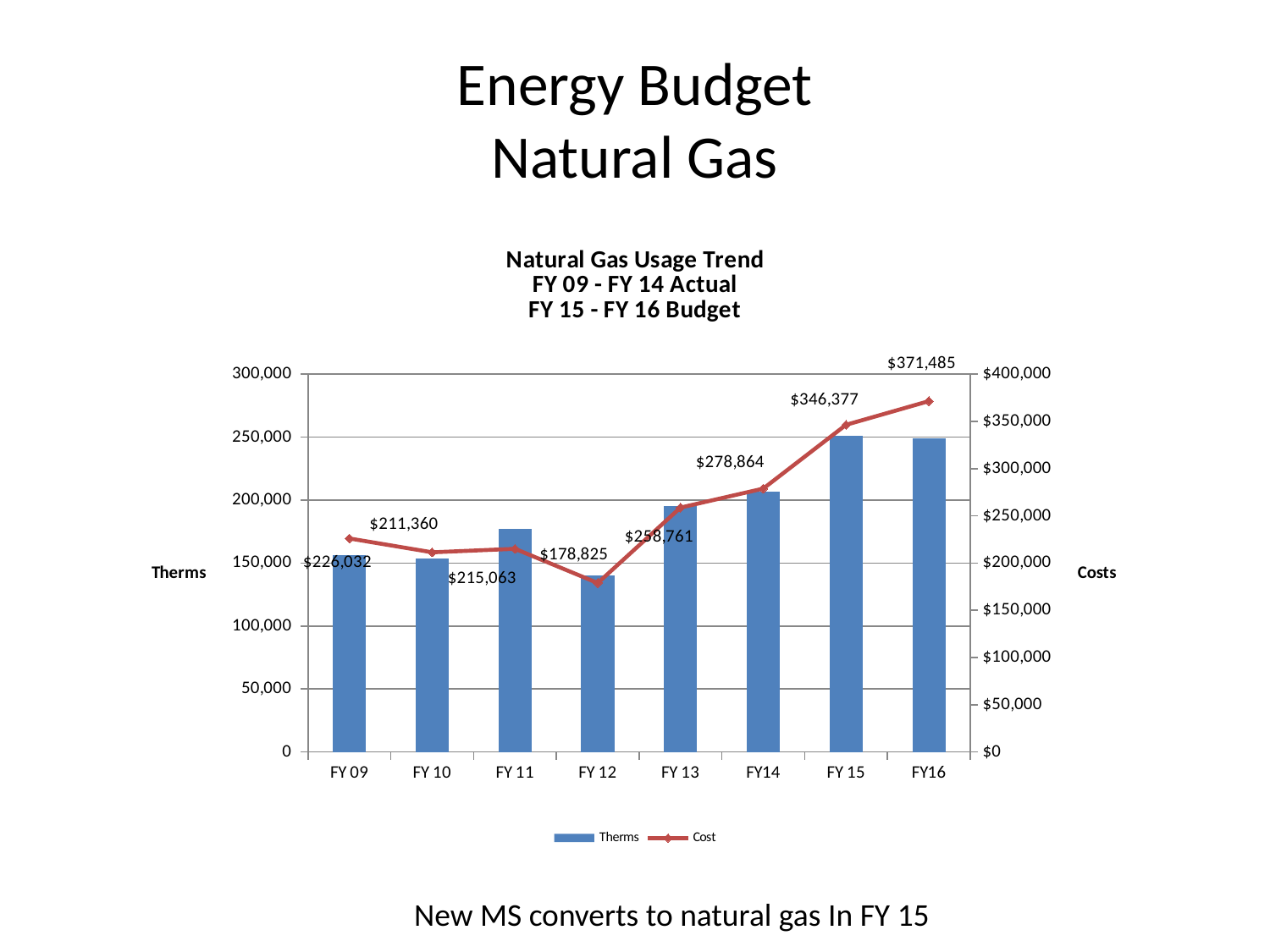
What is the cost value shown for FY16? $371,485 Which is larger, the cost for FY 09 or the cost for FY 10? FY 09 What is the cost value shown for FY 12? $178,825 Is the Therms value for FY 12 greater or less than 150,000? less What is the difference between the cost for FY16 and the cost for FY 15? $25,108 Is the Therms value for FY 15 greater or less than 200,000? greater How many series does the legend list? 2 How many fiscal years are shown on the x axis? 8 What is the cost value shown for FY 15? $346,377 Which fiscal year has the highest cost? FY16 Does the cost rise or fall from FY 12 to FY16? rise Which fiscal year has the lowest cost? FY 12